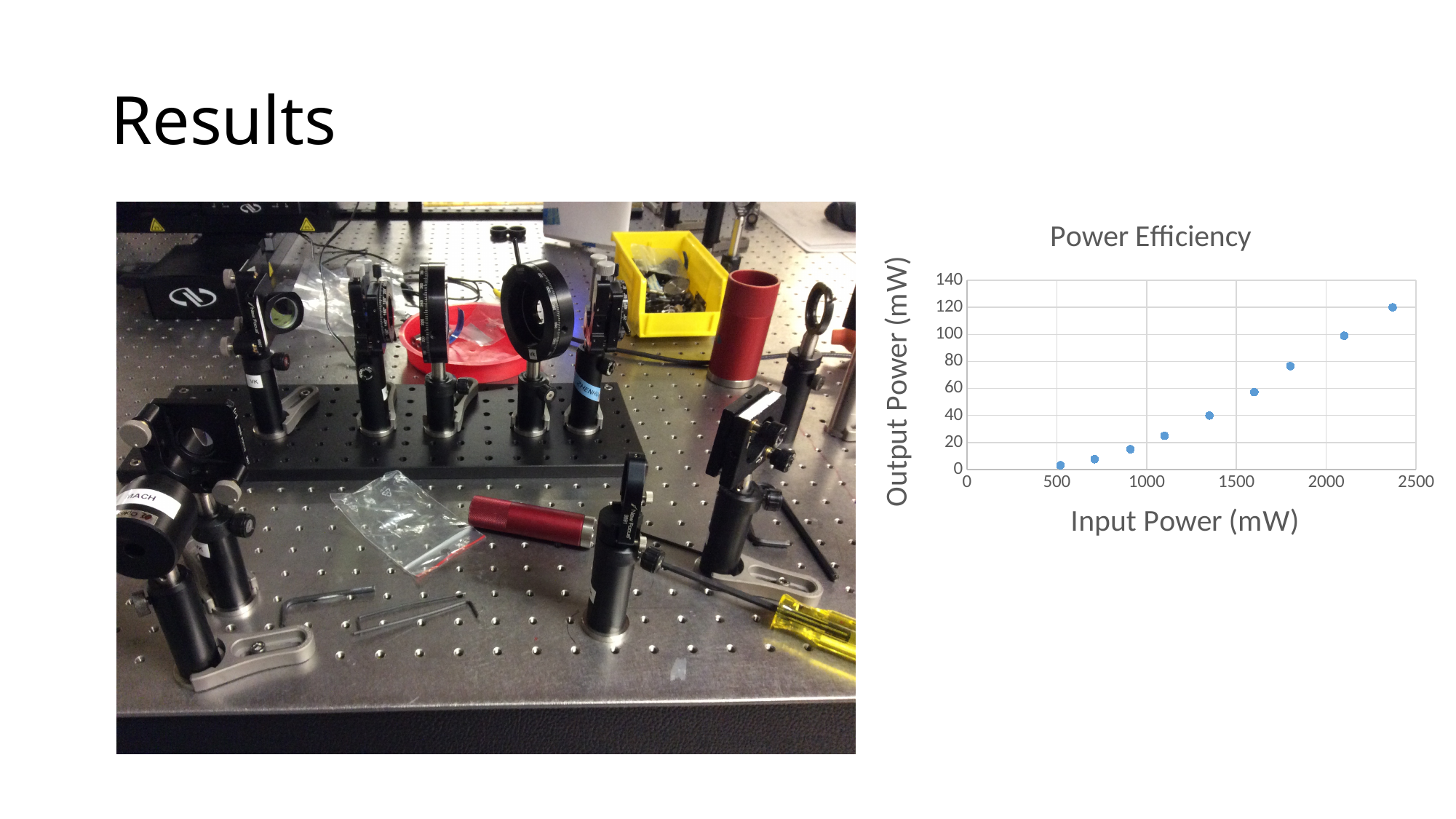
In the Power Efficiency chart, which has the higher output power: the point at about 1600 mW input or the point at about 2100 mW input? the point at about 2100 mW input How many data points are plotted in the Power Efficiency chart? 9 In the Power Efficiency chart, is the output power for the highest input power point greater or less than 100? greater In the Power Efficiency chart, is the output power for the lowest input power point greater or less than 20? less In the Power Efficiency chart, is the output power at an input power of about 1100 mW greater or less than 40? less In the Power Efficiency chart, does output power rise or fall as input power increases? rise What is the title of the chart on the slide? Power Efficiency What kind of chart is the Power Efficiency chart? scatter chart What is the label of the x axis in the Power Efficiency chart? Input Power (mW) What is the maximum value shown on the y axis of the Power Efficiency chart? 140